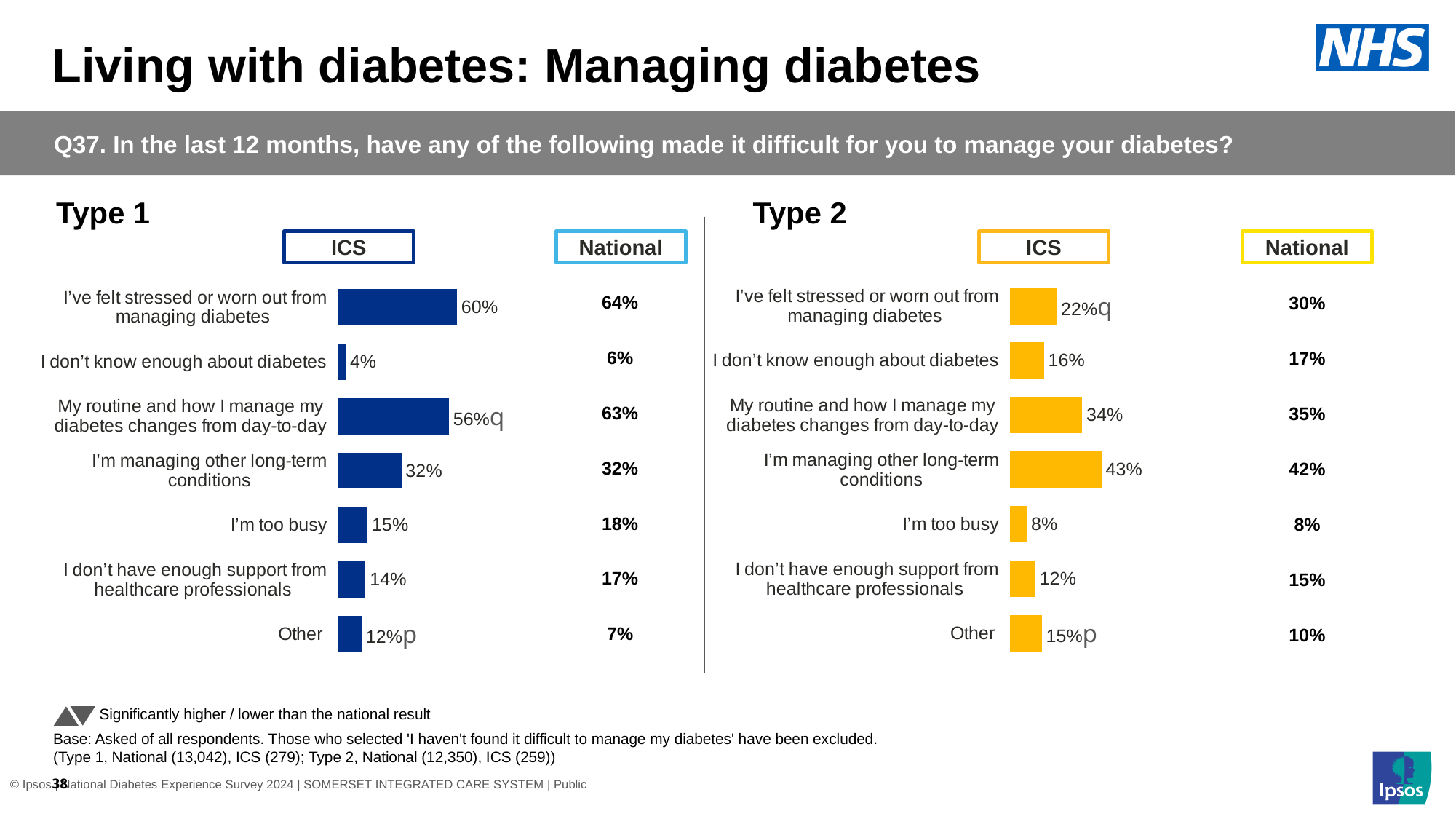
In the Type 2 chart, what is the ICS value for 'I'm too busy'? 8% In the Type 2 chart, what is the difference between the ICS and National values for 'I've felt stressed or worn out from managing diabetes'? 8 percentage points What colour are the ICS bars in the Type 2 chart? Yellow In the Type 2 chart, what is the ICS value for 'I'm managing other long-term conditions'? 43% In the Type 2 chart, which category has the highest ICS value? I'm managing other long-term conditions In the Type 1 chart, how many categories are shown? 7 In the Type 1 chart, what is the difference between the ICS and National values for 'I've felt stressed or worn out from managing diabetes'? 4 percentage points In the Type 1 chart, what is the National value for 'Other'? 7% In the Type 1 chart, what is the ICS value for 'I've felt stressed or worn out from managing diabetes'? 60% In the Type 1 chart, which category has the lowest ICS value? I don't know enough about diabetes What type of chart is used for the ICS values in the Type 1 chart? Bar chart In the Type 2 chart, which is larger for 'Other': the ICS value or the National value? ICS